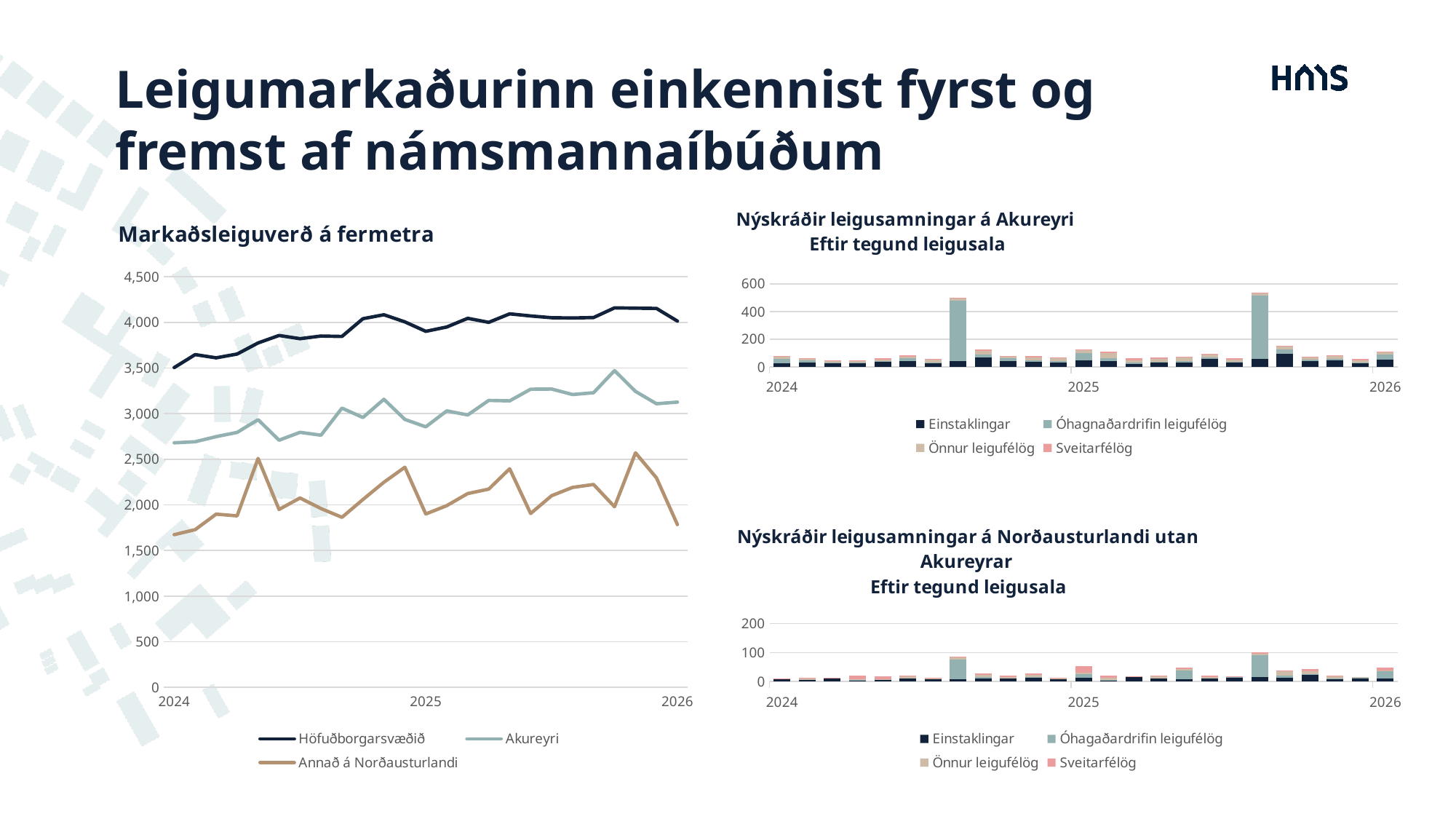
In "Markaðsleiguverð á fermetra", is the value for Höfuðborgarsvæðið at the start of 2024 greater or less than 4,000? less What kind of chart is "Nýskráðir leigusamningar á Akureyri"? bar chart How many series does the legend of "Nýskráðir leigusamningar á Akureyri" list? 4 In "Markaðsleiguverð á fermetra", which series has the highest values across the whole period? Höfuðborgarsvæðið In "Nýskráðir leigusamningar á Akureyri", which series makes up most of the two tallest bars? Óhagnaðardrifin leigufélög In "Markaðsleiguverð á fermetra", does the Höfuðborgarsvæðið line overall rise or fall from 2024 to 2026? rise What kind of chart is "Markaðsleiguverð á fermetra"? line chart How many series does the legend of "Markaðsleiguverð á fermetra" list? 3 In "Markaðsleiguverð á fermetra", which is larger at the start of 2024: Höfuðborgarsvæðið or Annað á Norðausturlandi? Höfuðborgarsvæðið In "Nýskráðir leigusamningar á Akureyri", is the tallest bar greater or less than 400? greater In "Markaðsleiguverð á fermetra", is the value for Akureyri at the start of 2024 greater or less than 3,000? less In "Markaðsleiguverð á fermetra", which series has the lowest values across the whole period? Annað á Norðausturlandi